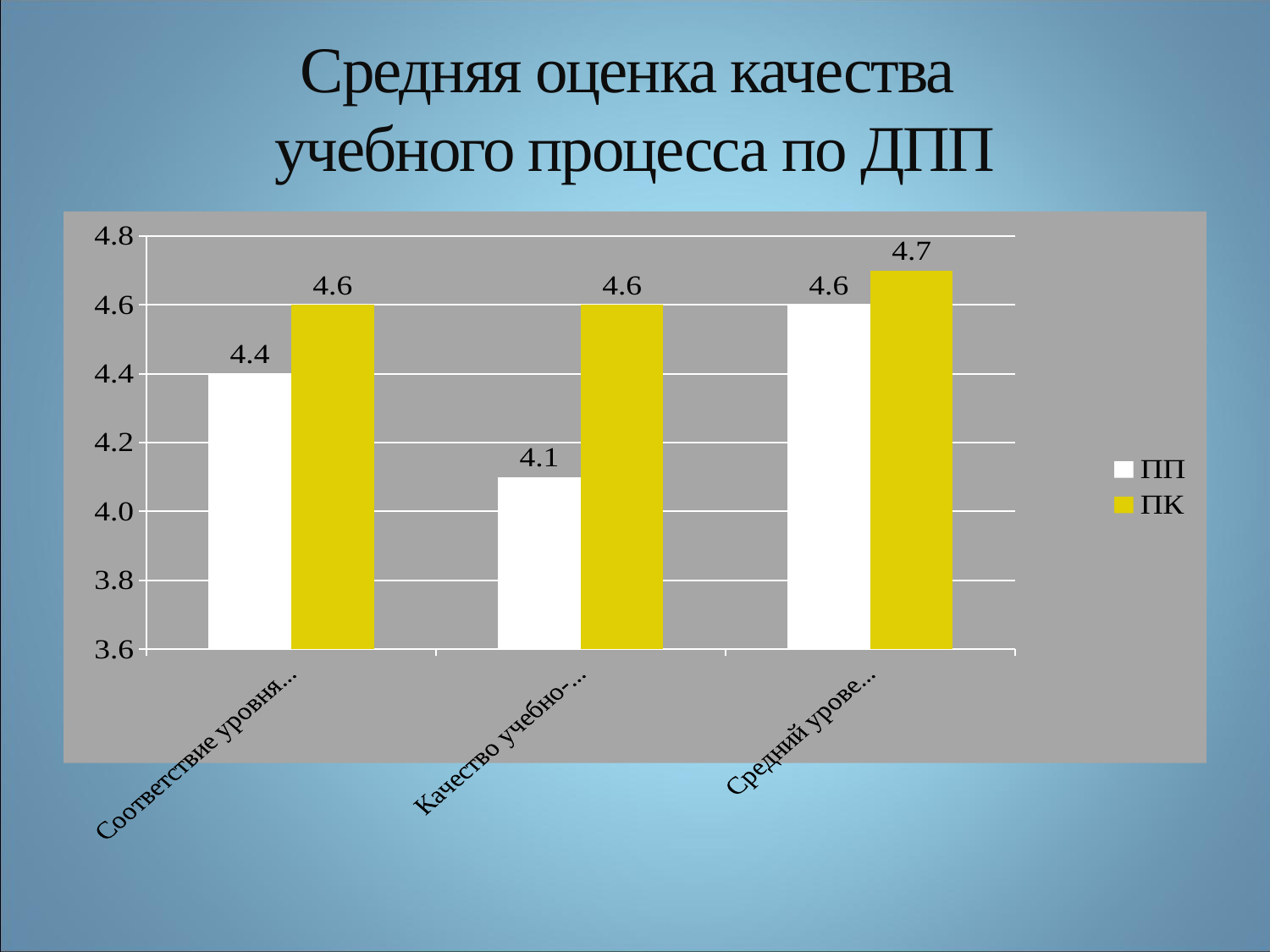
For the first category (Соответствие уровня...), which series has the larger value, ПП or ПК? ПК Is the ПП value for the second category (Качество учебно-...) greater or less than 4.2? less How many categories are shown on the x axis? 3 Which category has the highest value in the ПК series? Средний урове... What is the value of the ПК series for the second category (Качество учебно-...)? 4.6 What is the value of the ПП series for the third category (Средний урове...)? 4.6 What kind of chart is shown on the slide? bar chart What is the value of the ПП series for the first category (Соответствие уровня...)? 4.4 What is the difference between the ПК and ПП values for the second category (Качество учебно-...)? 0.5 Which category has the lowest value in the ПП series? Качество учебно-... What colour are the bars of the ПК series? yellow How many series does the legend list? 2